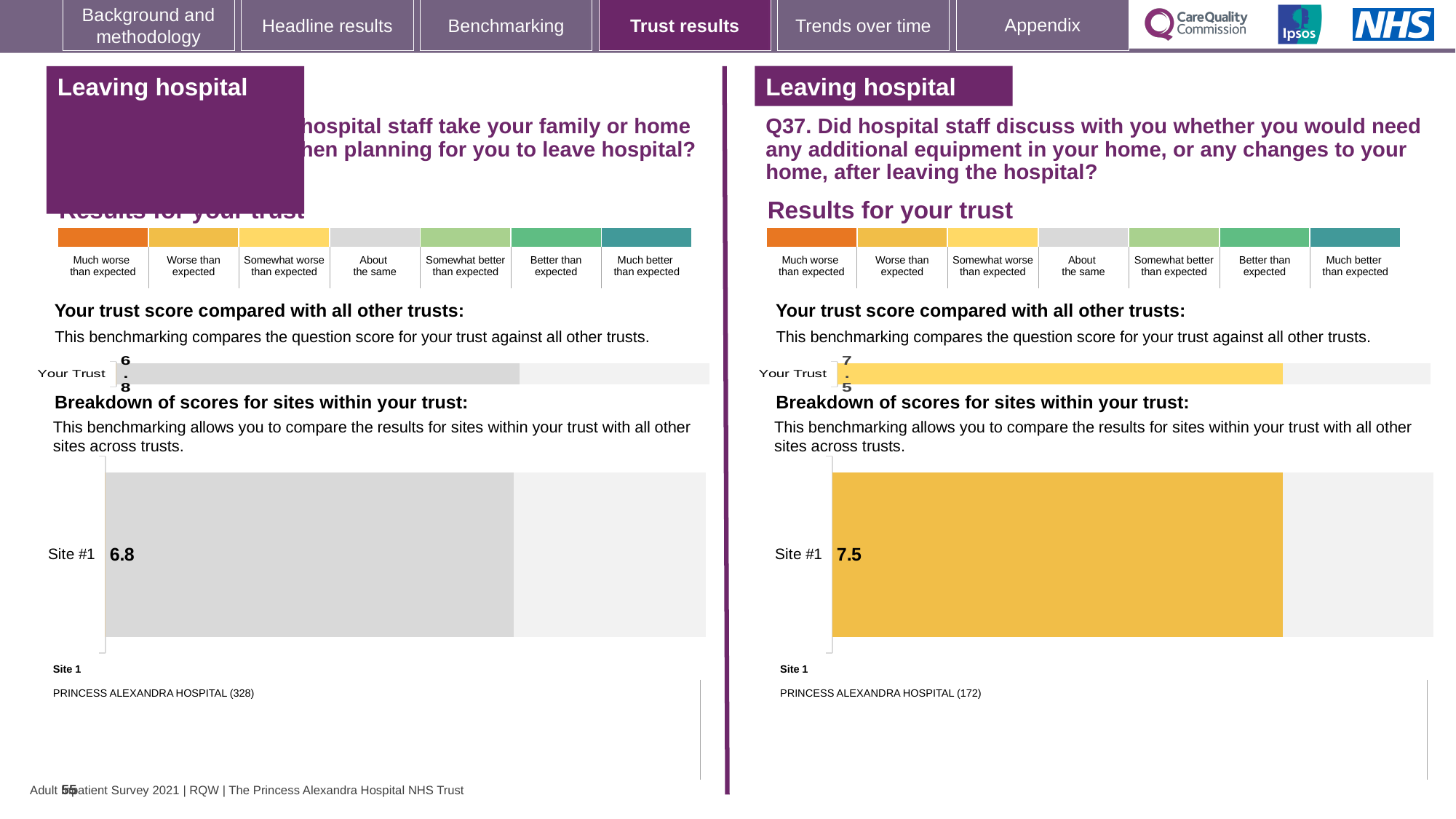
On the right half of the slide (Q37), what is the 'Your Trust' score in the trust score comparison chart? 7.5 What kind of chart is used to show the breakdown of scores for sites within your trust on the right half of the slide (Q37)? Bar chart How many sites are shown in the breakdown of scores chart on the left half of the slide? 1 What colour is the Site #1 bar in the breakdown chart for Q37 on the right half of the slide? Yellow What is the name of Site 1 listed under the breakdown chart for Q37 on the right half of the slide? PRINCESS ALEXANDRA HOSPITAL (172) On the right half of the slide (Q37), what is the score shown for Site #1 in the breakdown of scores for sites within your trust? 7.5 How many sites are shown in the breakdown of scores chart for Q37 on the right half of the slide? 1 What is the difference between the Site #1 score for Q37 on the right half of the slide and the Site #1 score on the left half? 0.7 Is the Site #1 score on the left half of the slide greater or less than 7? less On the left half of the slide, what is the score shown for Site #1 in the breakdown of scores for sites within your trust? 6.8 On the left half of the slide, what is the 'Your Trust' score in the trust score comparison chart? 6.8 Which Site #1 score is larger: the one on the left half of the slide or the one for Q37 on the right half? Q37 on the right half (7.5)